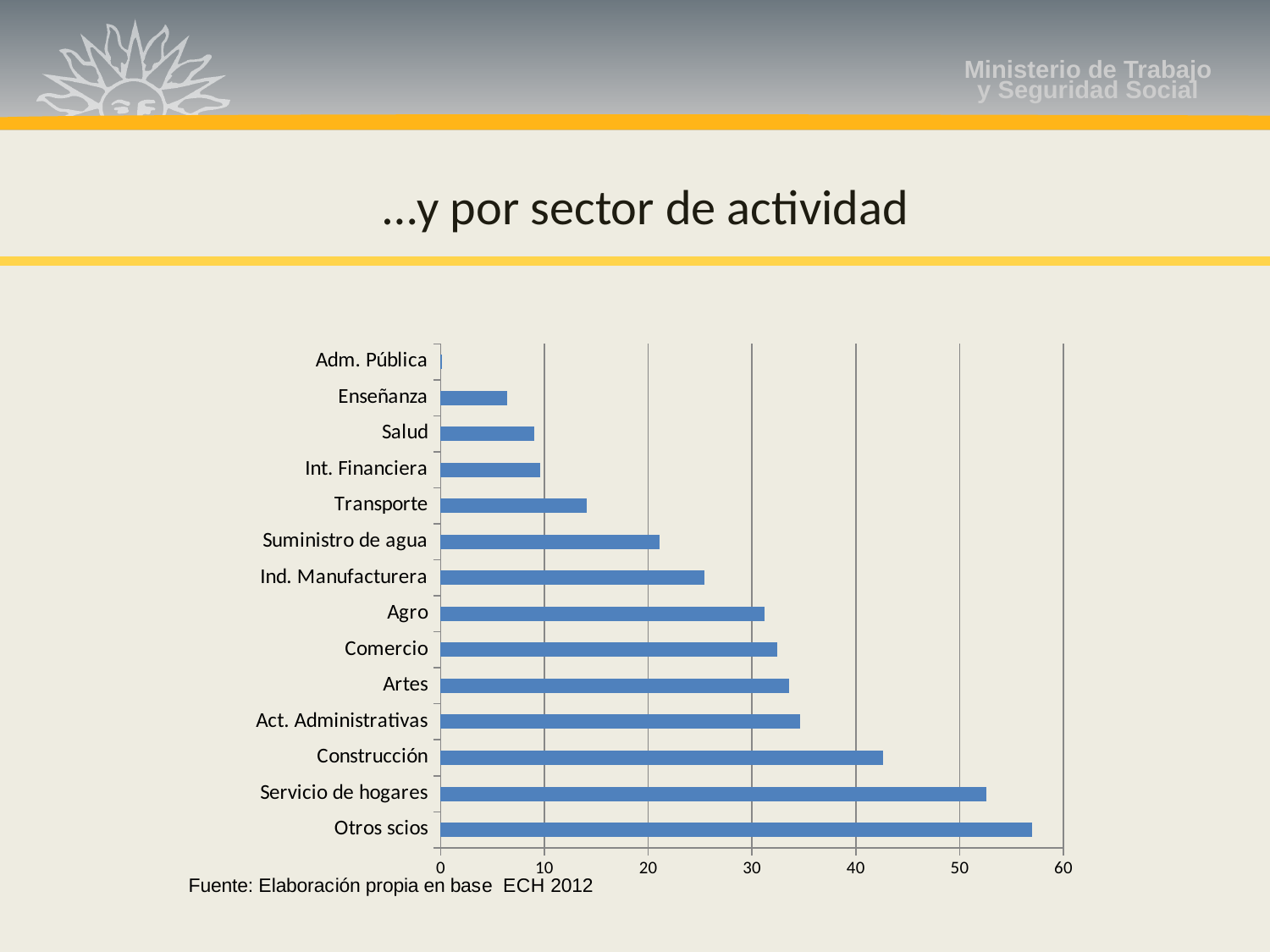
Is the value for Construcción greater or less than 40? greater What kind of chart is shown on the slide? bar chart Is the value for Transporte greater or less than 20? less How many sectors (categories) are plotted in the chart? 14 Is the value for Servicio de hogares greater or less than 50? greater Which sector has the lowest value in the chart? Adm. Pública Which sector has the highest value in the chart? Otros scios Which has a larger value, Construcción or Agro? Construcción What is the title of the slide containing the chart? …y por sector de actividad Which has a larger value, Suministro de agua or Salud? Suministro de agua